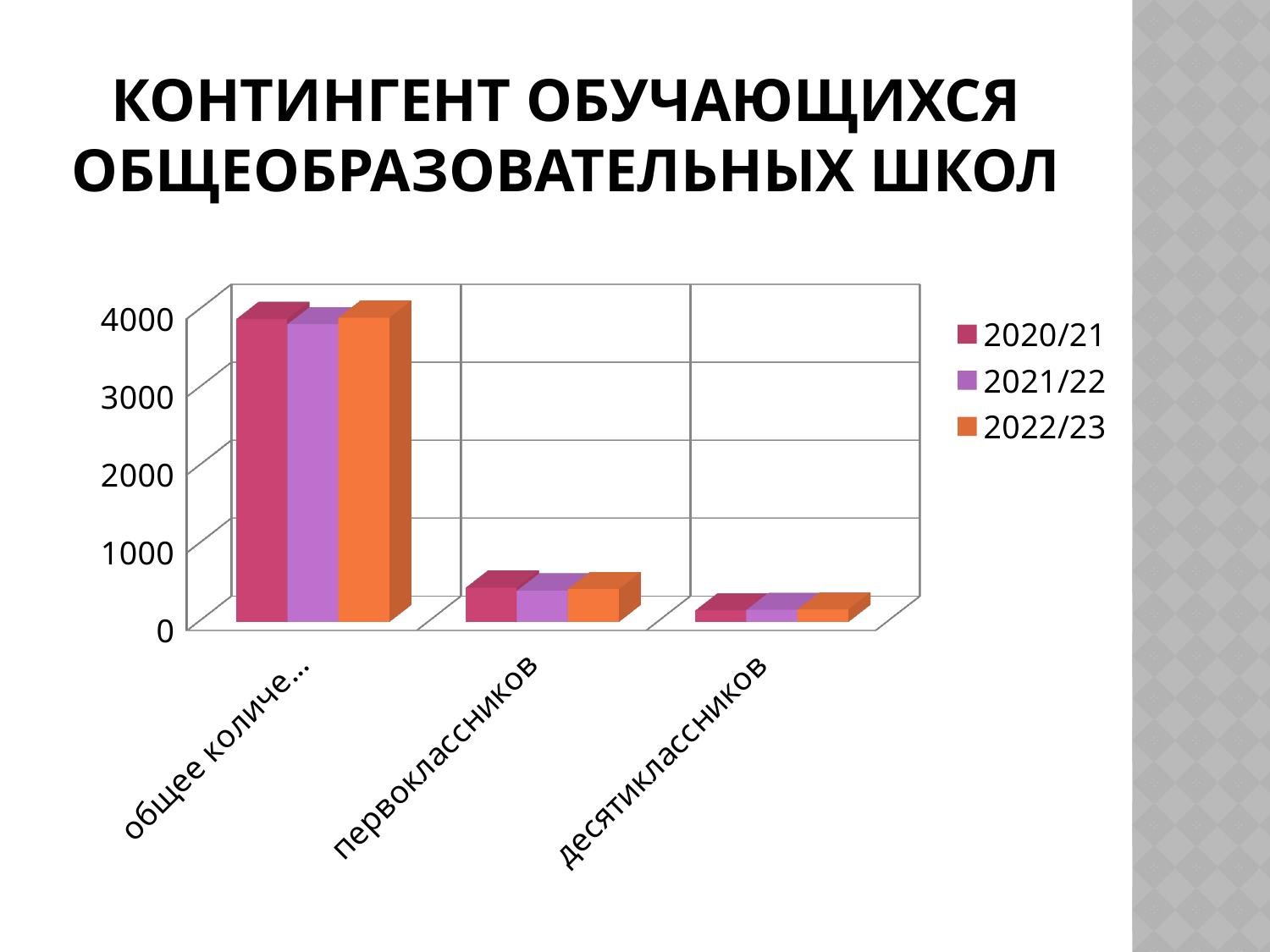
For 2022/23, which is larger: первоклассников or десятиклассников? первоклассников Is the value for десятиклассников in 2020/21 greater or less than 1000? less How many categories are shown on the x axis? 3 What kind of chart is shown on the slide? bar chart Which series are listed in the legend? 2020/21, 2021/22, 2022/23 What is the title of the slide? КОНТИНГЕНТ ОБУЧАЮЩИХСЯ ОБЩЕОБРАЗОВАТЕЛЬНЫХ ШКОЛ Is the value for the leftmost category in 2021/22 greater or less than 3000? greater Is the value for первоклассников in 2022/23 greater or less than 1000? less How many series does the legend list? 3 Which category has the highest values across all series? the leftmost category (общее количе...) Which category has the lowest values across all series? десятиклассников For 2020/21, which is larger: десятиклассников or первоклассников? первоклассников